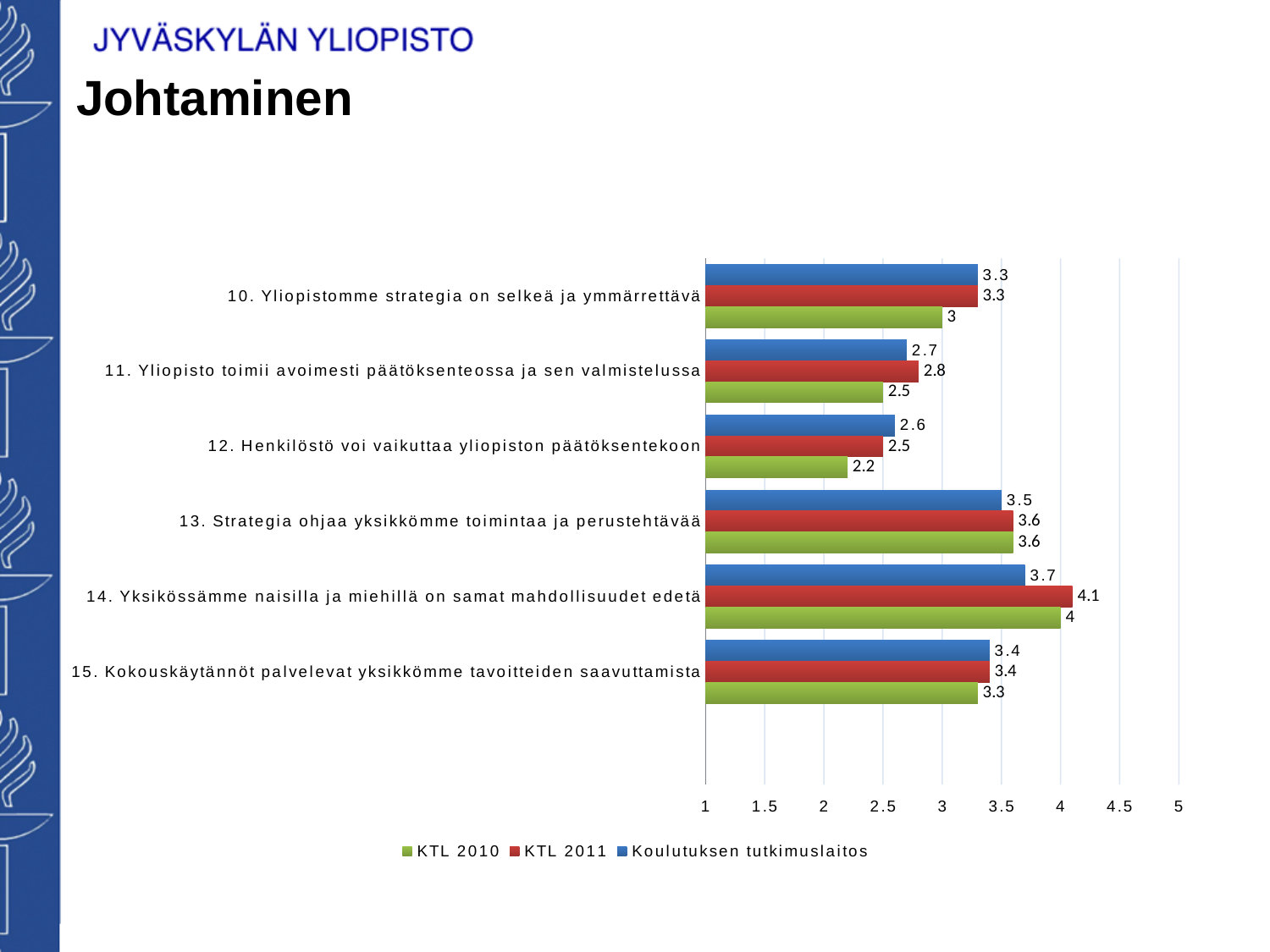
What is the difference between the KTL 2011 and KTL 2010 values for statement 10 (Yliopistomme strategia on selkeä ja ymmärrettävä)? 0.3 Which statement has the highest KTL 2011 value? 14. Yksikössämme naisilla ja miehillä on samat mahdollisuudet edetä What kind of chart is shown on the slide? bar chart Which statement has the lowest KTL 2010 value? 12. Henkilöstö voi vaikuttaa yliopiston päätöksentekoon How many series does the legend list? 3 Which colour represents the KTL 2011 series in the chart? red What is the KTL 2010 value for statement 12 (Henkilöstö voi vaikuttaa yliopiston päätöksentekoon)? 2.2 For statement 14, which is larger: the KTL 2011 value or the Koulutuksen tutkimuslaitos value? KTL 2011 How many categories (statements) are plotted on the chart? 6 What is the KTL 2011 value for statement 14 (Yksikössämme naisilla ja miehillä on samat mahdollisuudet edetä)? 4.1 What is the Koulutuksen tutkimuslaitos value for statement 11 (Yliopisto toimii avoimesti päätöksenteossa ja sen valmistelussa)? 2.7 Is the KTL 2010 value for statement 13 (Strategia ohjaa yksikkömme toimintaa ja perustehtävää) greater or less than 3? greater